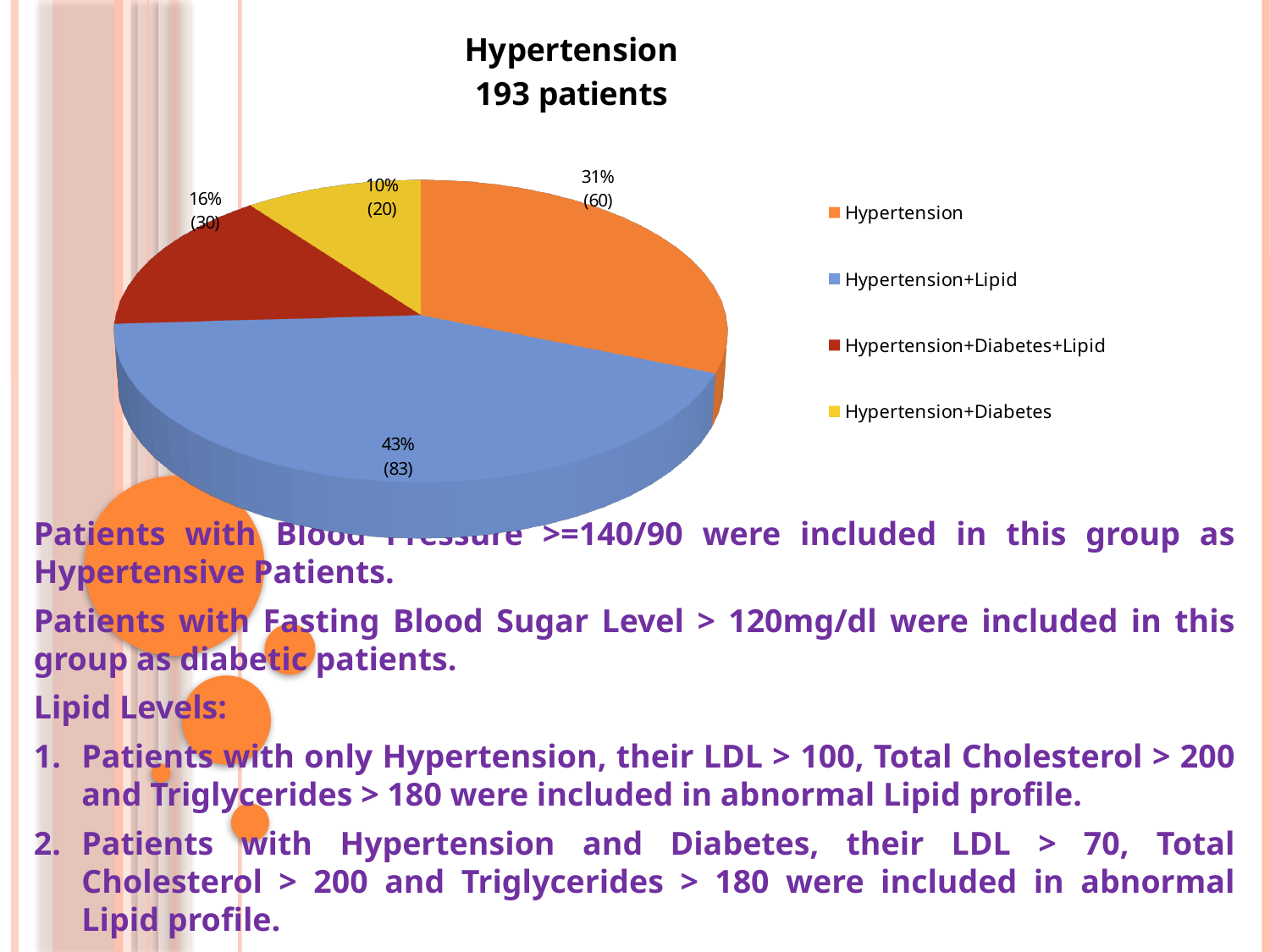
Which group has the largest share of the pie? Hypertension+Lipid Which group has the smallest share of the pie? Hypertension+Diabetes How many slices does the pie chart have? 4 Which group has more patients, Hypertension+Diabetes+Lipid or Hypertension+Diabetes? Hypertension+Diabetes+Lipid What percentage of patients had Hypertension only? 31% How many entries does the legend list? 4 How many patients are in the Hypertension+Diabetes+Lipid group? 30 What is the title of the chart? Hypertension 193 patients What is the difference in patient count between the Hypertension+Lipid group and the Hypertension group? 23 What percentage of patients had Hypertension+Lipid? 43% What kind of chart is shown on the slide? Pie chart How many patients are in the Hypertension+Lipid group? 83